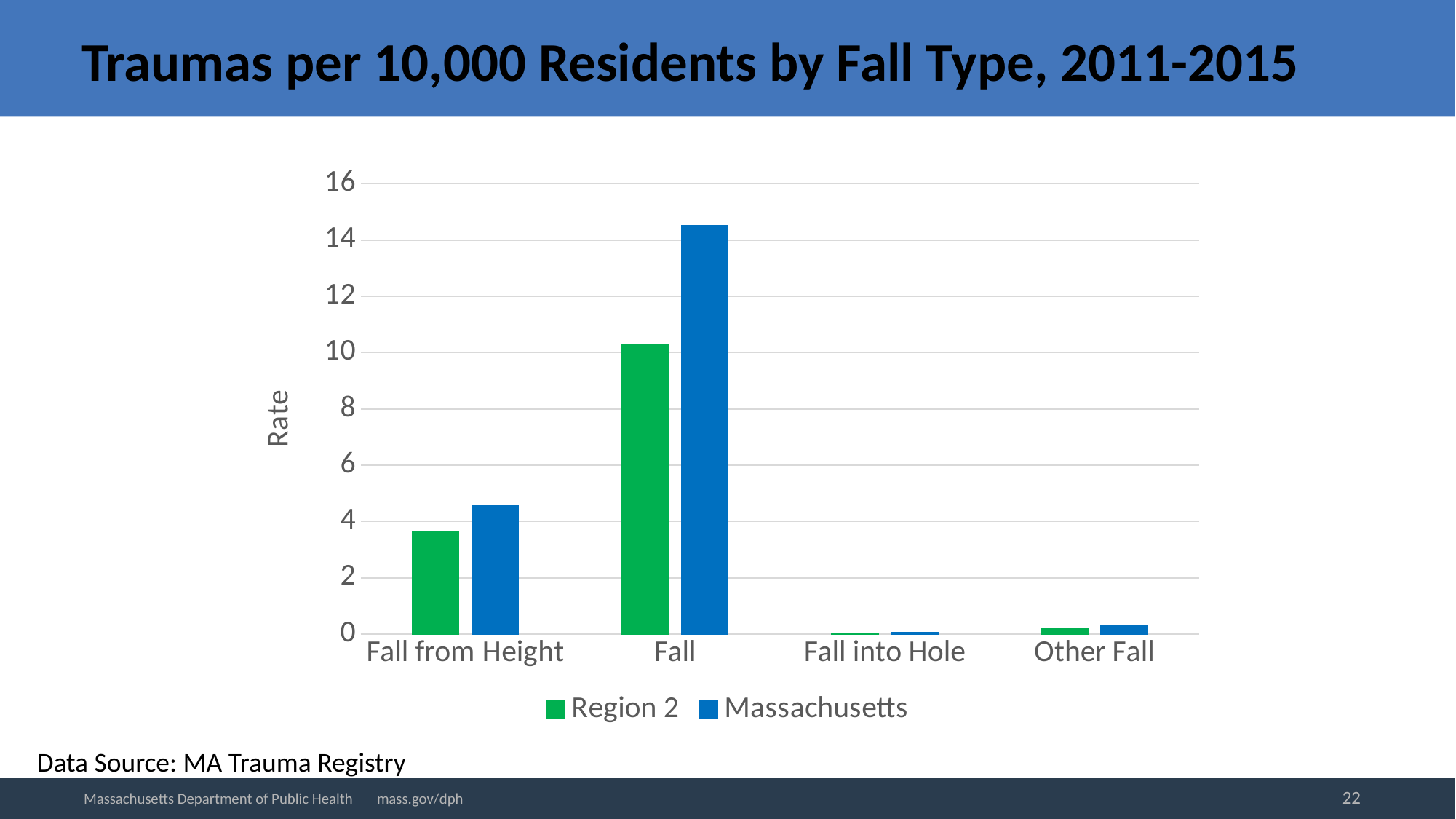
For Fall from Height, which series has the larger rate, Region 2 or Massachusetts? Massachusetts How many series does the legend list? 2 How many fall type categories are shown on the x axis? 4 For the Fall category, which series has the larger rate, Region 2 or Massachusetts? Massachusetts Which fall type has the lowest rate for Massachusetts? Fall into Hole What type of chart is shown on the slide? Bar chart What is the label on the vertical axis? Rate Is the Region 2 rate for Fall from Height greater or less than 4? less Is the Massachusetts rate for Fall greater or less than 14? greater Is the Region 2 rate for Fall greater or less than 8? greater Which fall type has the highest rate for Region 2? Fall Which fall type has the highest rate for Massachusetts? Fall